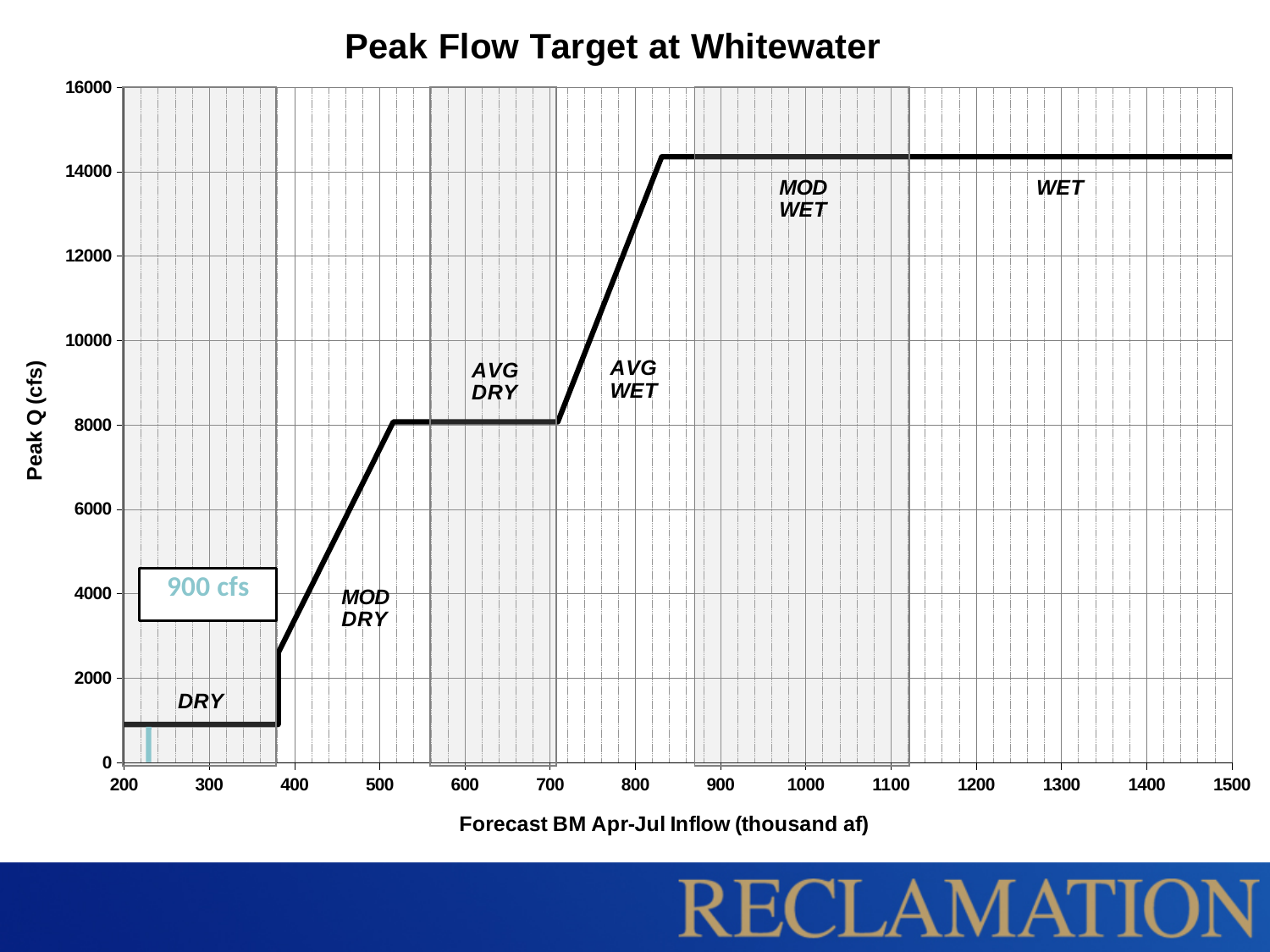
What peak flow value is labeled for the DRY zone? 900 cfs What is the title of the chart? Peak Flow Target at Whitewater Is the peak flow target at a forecast inflow of 650 greater or less than 10000? less What kind of chart is shown on the slide? line chart Does the peak flow target generally rise or fall as forecast inflow increases along the x axis? rise Is the peak flow target at a forecast inflow of 1000 greater or less than 12000? greater Is the peak flow target at a forecast inflow of 300 greater or less than 2000? less Which zone has the lowest peak flow target? DRY What is the label of the x axis? Forecast BM Apr-Jul Inflow (thousand af) How many hydrologic zones (DRY through WET) are labeled on the chart? 6 Which has the larger peak flow target: a forecast inflow of 300 or a forecast inflow of 1200? 1200